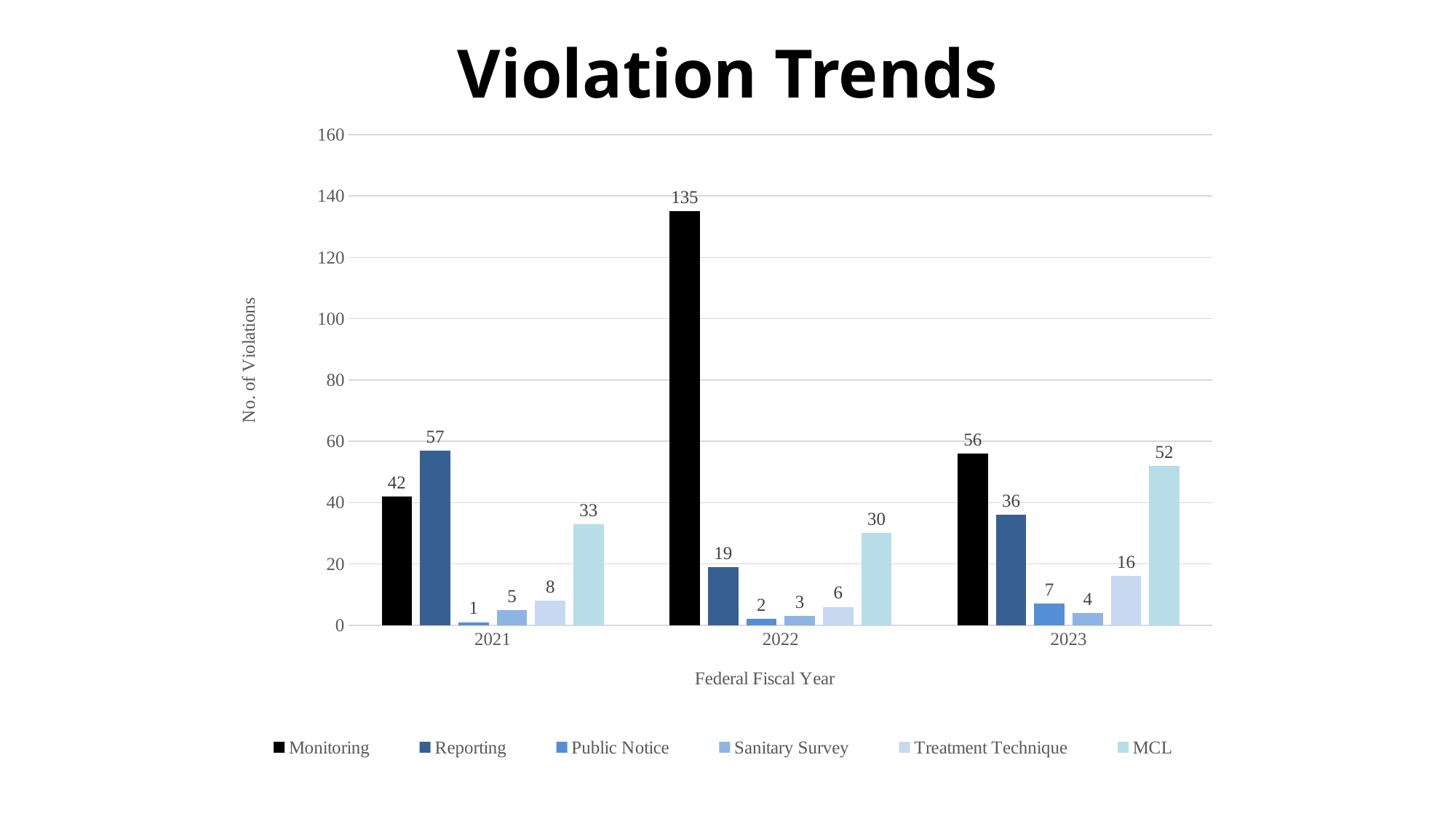
Which year has the lowest number of Public Notice violations? 2021 What is the number of Reporting violations in 2021? 57 Which year has the highest number of Monitoring violations? 2022 What is the number of Monitoring violations in 2022? 135 What is the number of MCL violations in 2023? 52 What is the difference between Monitoring violations in 2022 and 2023? 79 Is the value for Monitoring in 2022 greater or less than 120? greater How many fiscal years are shown on the x axis? 3 What kind of chart is shown on the slide? Bar chart Which is larger in 2023: Reporting violations or MCL violations? MCL How many series does the legend list? 6 What is the label of the y axis? No. of Violations